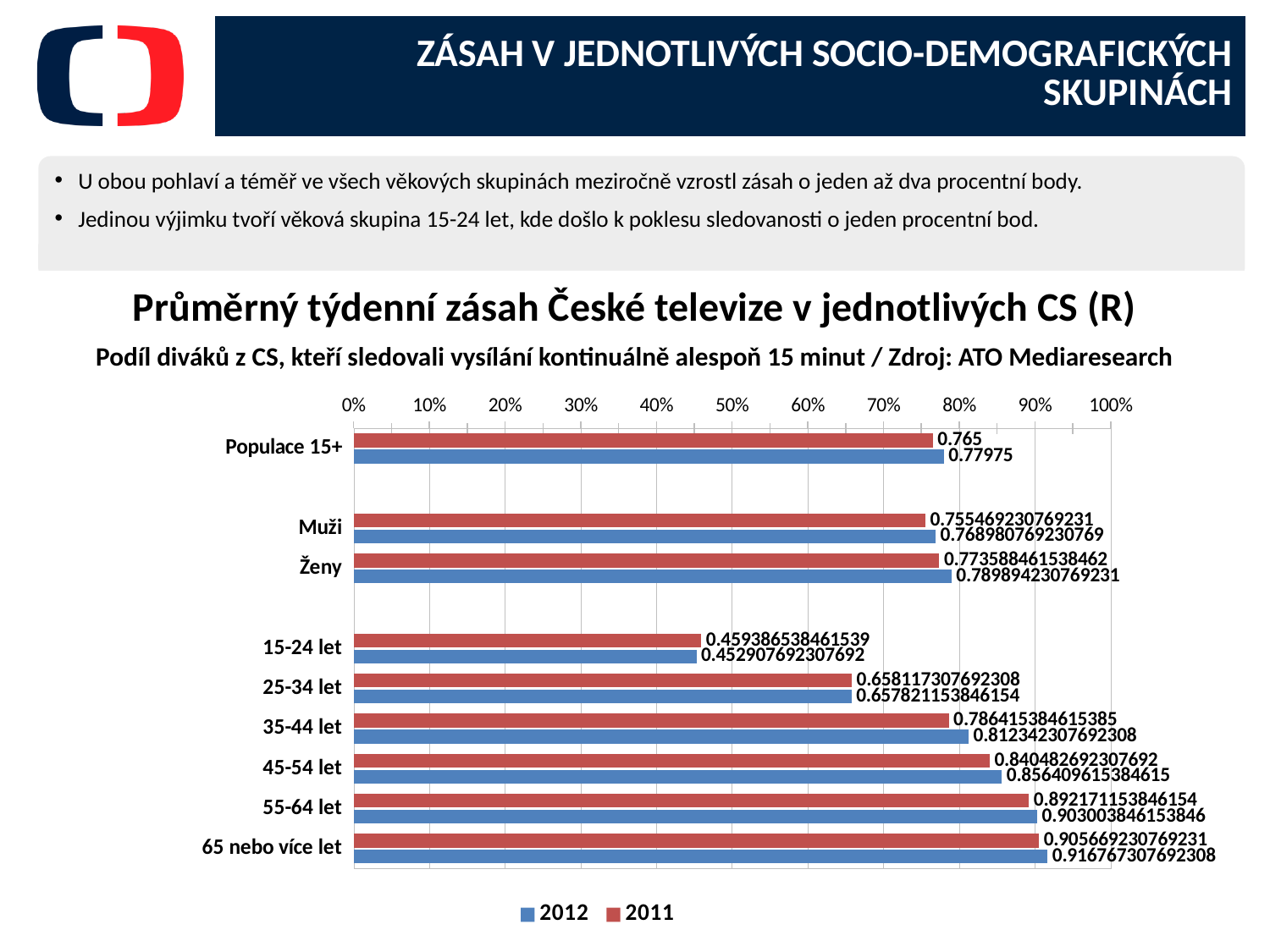
Which category has the lowest 2011 value? 15-24 let For 15-24 let, which is larger: the 2011 value or the 2012 value? 2011 How many categories are shown on the chart? 9 What is the 2012 value for Populace 15+? 0.77975 What is the 2011 value for 15-24 let? 0.459386538461539 What is the difference between the 2012 and 2011 values for Populace 15+? 0.01475 What is the 2011 value for Populace 15+? 0.765 How many series does the legend list? 2 Which category has the highest 2012 value? 65 nebo více let Is the 2012 value for 25-34 let greater or less than 70%? less What kind of chart is shown on the slide? bar chart What is the 2012 value for 65 nebo více let? 0.916767307692308